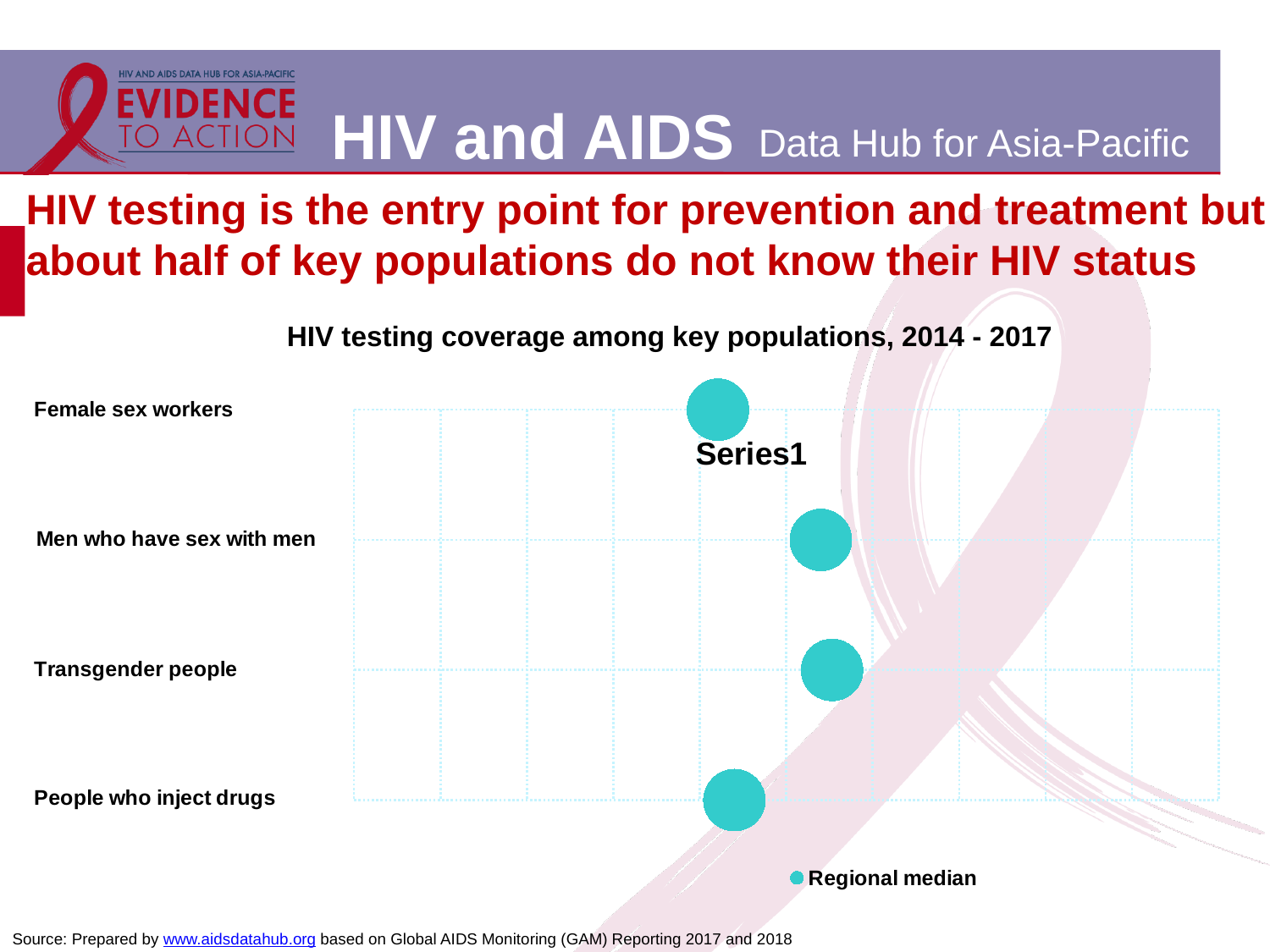
What series name is shown in the chart legend? Regional median Which has the larger regional median value, Men who have sex with men or People who inject drugs? Men who have sex with men What is the title of the chart? HIV testing coverage among key populations, 2014 - 2017 How many categories are plotted in the chart? 4 Which has the larger regional median value, Transgender people or People who inject drugs? Transgender people How many series does the chart legend list? 1 Which has the larger regional median value, Transgender people or Female sex workers? Transgender people What kind of chart is shown on the slide? dot chart